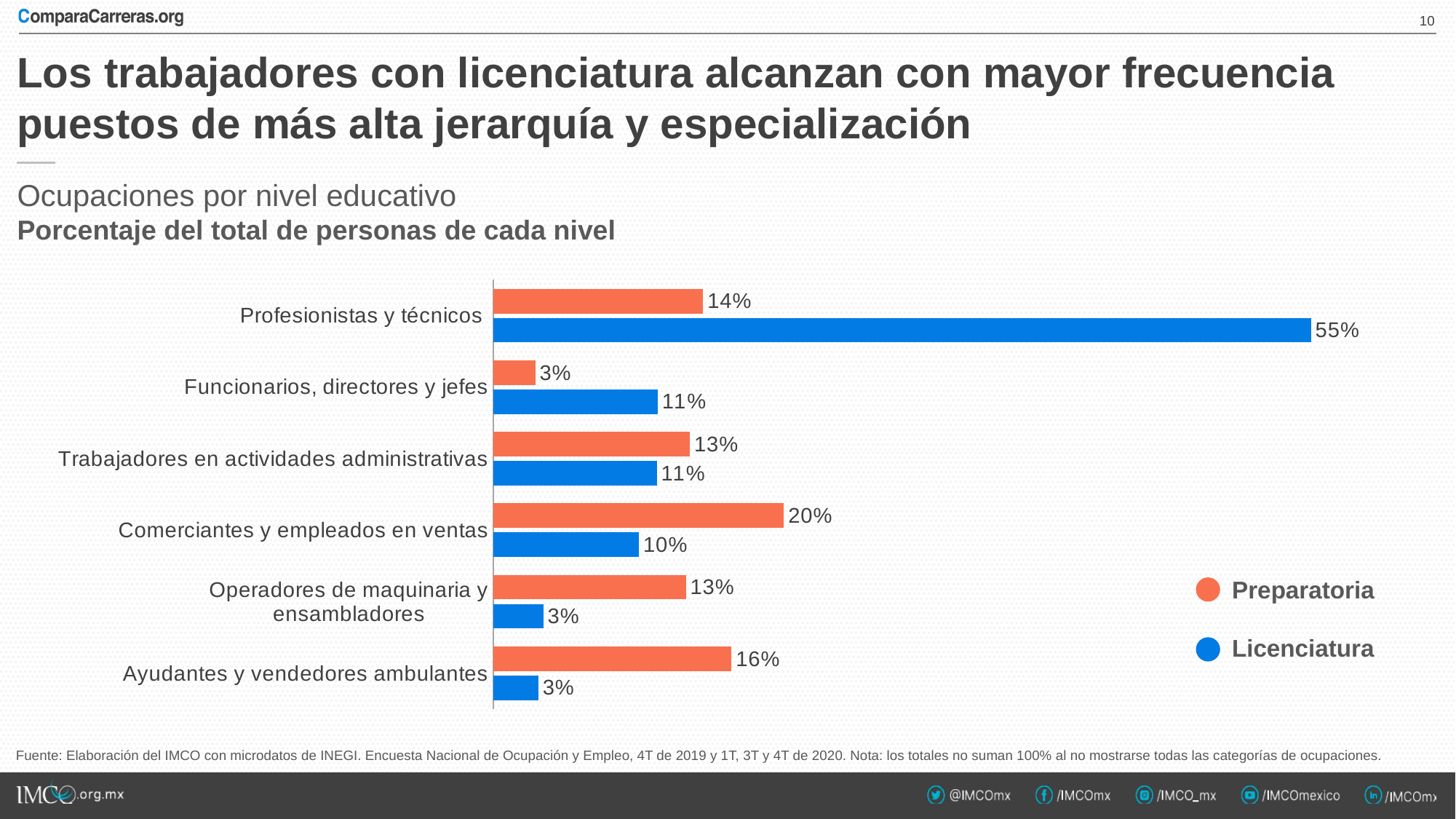
Which colour represents Licenciatura in the chart? Blue What is the Preparatoria value for Comerciantes y empleados en ventas? 20% How many occupation categories are shown in the chart? 6 What type of chart is shown on the slide? Bar chart What is the Licenciatura value for Operadores de maquinaria y ensambladores? 3% How many series does the legend list? 2 What is the Licenciatura value for Profesionistas y técnicos? 55% Which occupation has the highest Preparatoria value? Comerciantes y empleados en ventas For Ayudantes y vendedores ambulantes, which is larger: the Preparatoria value or the Licenciatura value? Preparatoria What is the difference between the Licenciatura and Preparatoria values for Profesionistas y técnicos? 41% Which occupation has the lowest Preparatoria value? Funcionarios, directores y jefes Which occupation has the highest Licenciatura value? Profesionistas y técnicos